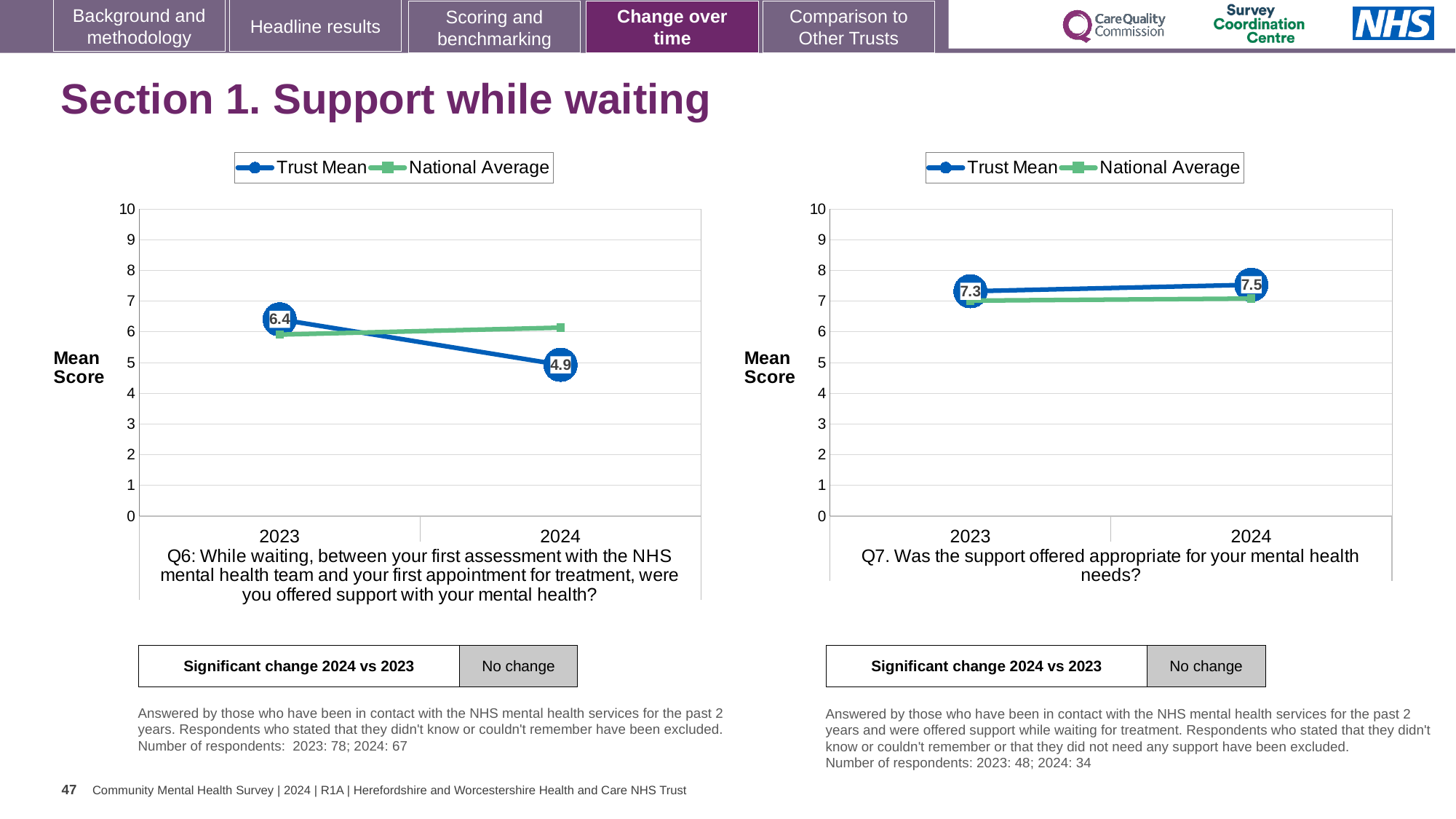
On the Q7 chart (right), what is the difference between the Trust Mean in 2024 and in 2023? 0.2 On the Q7 chart (right), does the Trust Mean rise or fall from 2023 to 2024? rise On the Q7 chart (right), is the National Average for 2023 greater or less than 8? less How many series does the legend of the Q6 chart (left) list? 2 On the Q6 chart (left), what is the Trust Mean score for 2024? 4.9 On the Q6 chart (left), by how much did the Trust Mean change from 2023 to 2024? 1.5 On the Q7 chart (right), what is the Trust Mean score for 2024? 7.5 On the Q6 chart (left), what is the Trust Mean score for 2023? 6.4 On the Q6 chart (left), does the Trust Mean rise or fall from 2023 to 2024? fall What kind of chart is the Q7 chart (right)? line chart On the Q7 chart (right), what is the Trust Mean score for 2023? 7.3 On the Q6 chart (left), in 2024 which is larger, the Trust Mean or the National Average? National Average